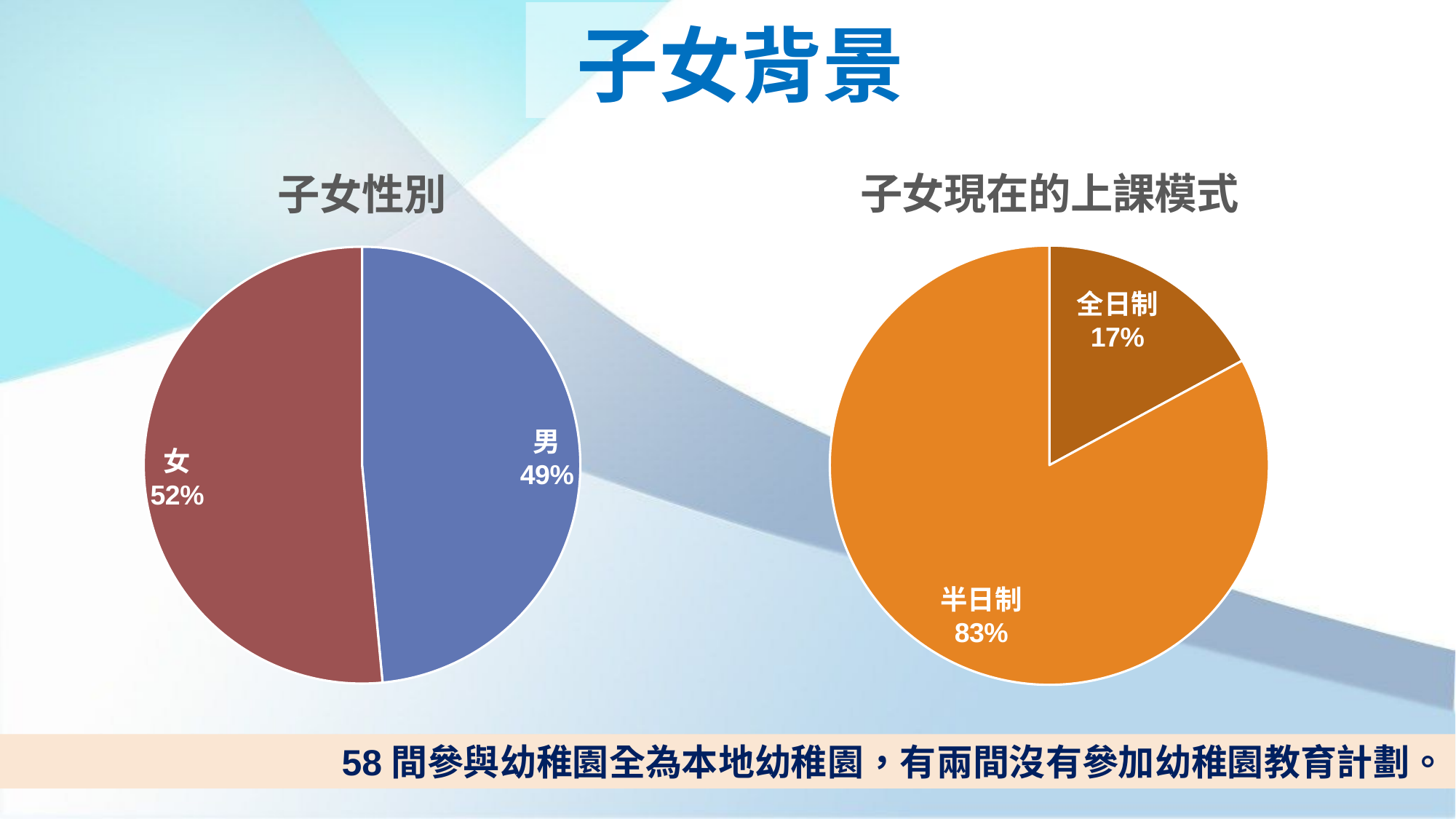
In the 子女現在的上課模式 chart, what share is labelled for 半日制? 83% In the 子女性別 chart, what is the difference in percentage points between 女 and 男? 3 In the 子女性別 chart, what share is labelled for 男? 49% In the 子女性別 chart, what share is labelled for 女? 52% In the 子女現在的上課模式 chart, which is larger, 全日制 or 半日制? 半日制 In the 子女現在的上課模式 chart, which category has the smallest slice? 全日制 In the 子女現在的上課模式 chart, what share is labelled for 全日制? 17% How many slices does the 子女性別 chart have? 2 In the 子女現在的上課模式 chart, what is the difference in percentage points between 半日制 and 全日制? 66 What kind of chart is the 子女現在的上課模式 chart? pie chart In the 子女現在的上課模式 chart, which category has the largest slice? 半日制 What is the title of the chart on the left of the slide? 子女性別